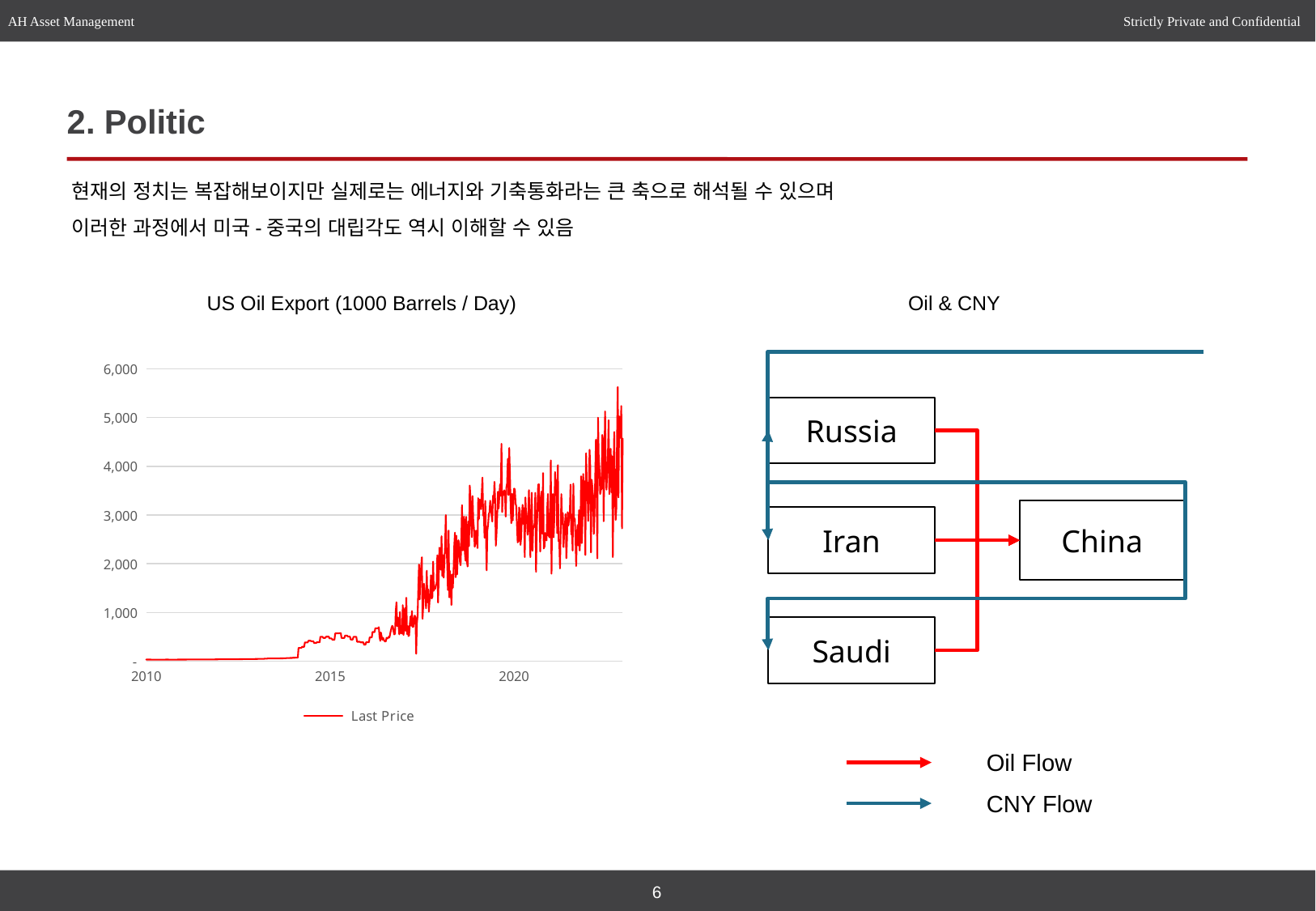
What is the title of the chart on the left of the slide? US Oil Export (1000 Barrels / Day) In the US Oil Export chart, is the value at the start of 2020 greater or less than 5,000? less What kind of chart is the US Oil Export chart? line chart What is the name of the series shown in the legend of the US Oil Export chart? Last Price In the US Oil Export chart, is the value higher in 2010 or in 2020? 2020 In the US Oil Export chart, is the value in 2010 greater or less than 1,000? less In the US Oil Export chart, is the value at the start of 2015 greater or less than 1,000? less In the US Oil Export chart, do the values generally rise or fall from 2010 to the end of the series? rise How many series does the legend of the US Oil Export chart list? 1 What is the highest value shown on the y axis of the US Oil Export chart? 6,000